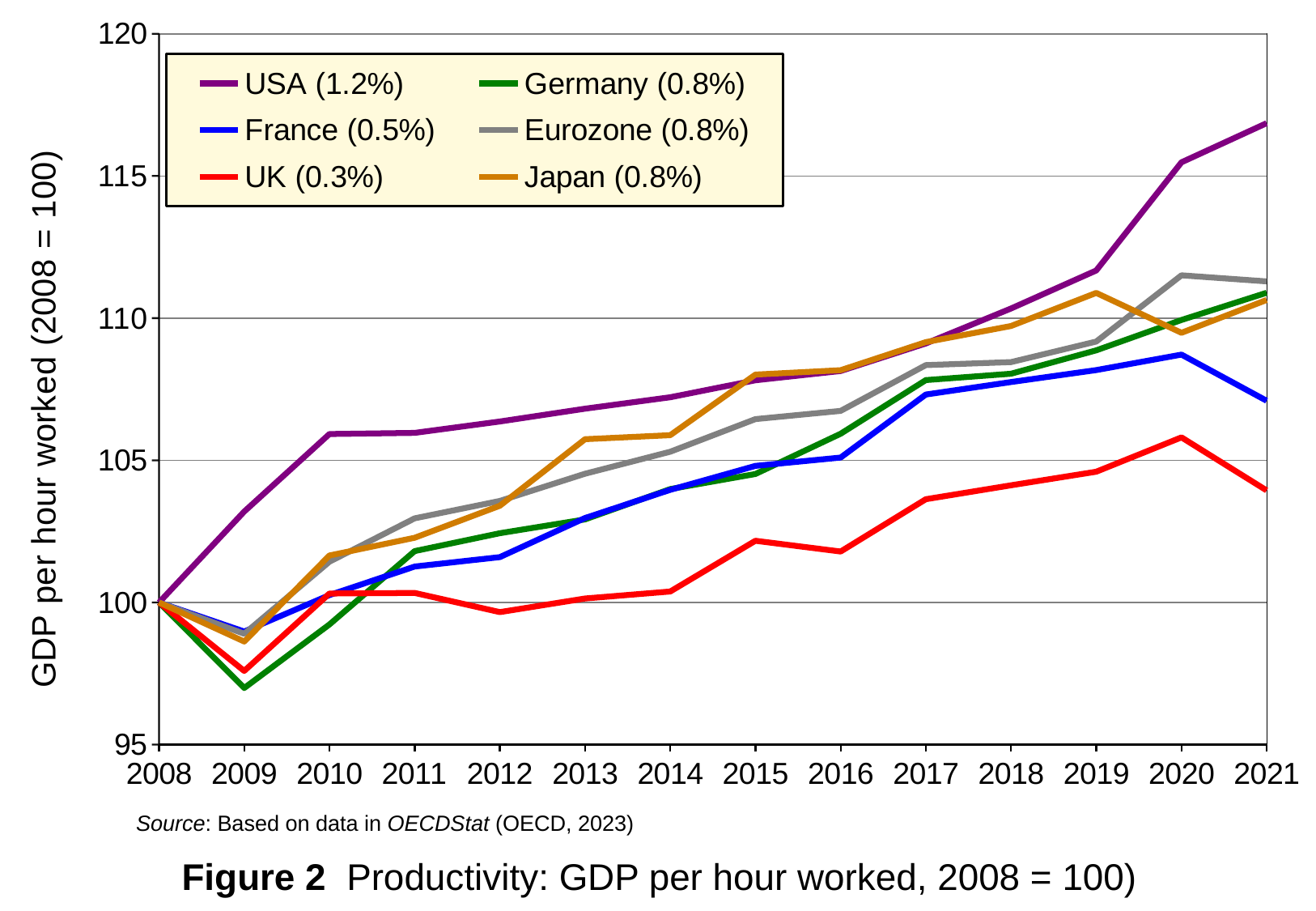
How many years are plotted along the x axis? 14 Which series has the lowest value in 2021? UK What growth rate is shown in the legend next to USA? 1.2% Is the value for USA in 2021 greater or less than 115? greater Does the USA series generally rise or fall from 2008 to 2021? rise Is the value for Eurozone in 2020 greater or less than 110? greater Which series has the lowest value in 2009? Germany How many series does the legend list? 6 What kind of chart is shown in Figure 2? line chart Which series has the highest value in 2021? USA Is the value for UK in 2021 greater or less than 105? less In 2021, which is larger, the value for Germany or the value for France? Germany